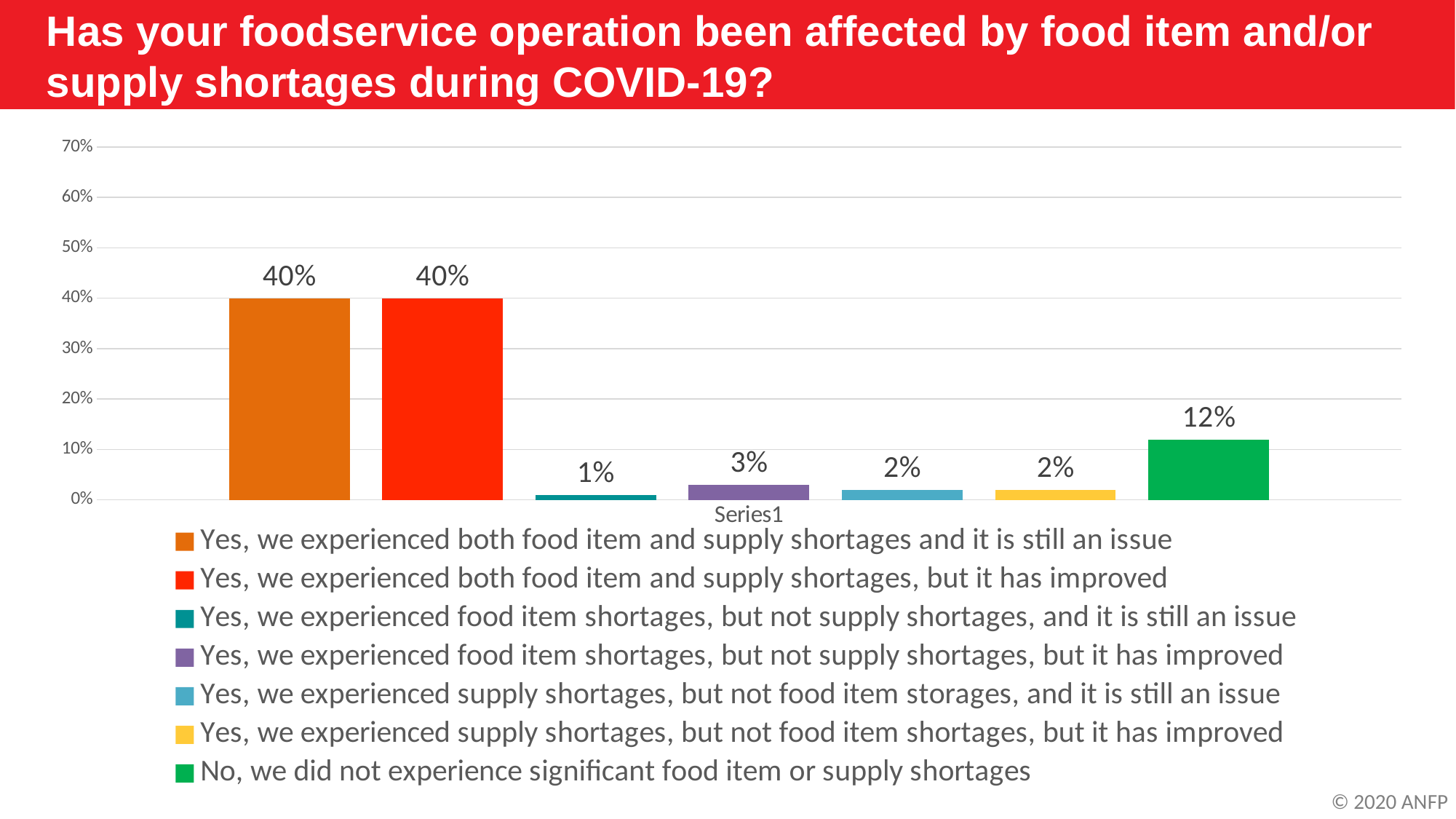
What percentage of respondents said they did not experience significant food item or supply shortages? 12% What colour is the bar for 'No, we did not experience significant food item or supply shortages'? Green Is the value for 'Yes, we experienced both food item and supply shortages, but it has improved' greater or less than 30%? greater What type of chart is shown on the slide? Bar chart Which is larger: the percentage for 'No, we did not experience significant food item or supply shortages' or the percentage for 'Yes, we experienced food item shortages, but not supply shortages, but it has improved'? No, we did not experience significant food item or supply shortages How many entries does the legend list? 7 What percentage of respondents said they experienced supply shortages, but not food item shortages, but it has improved? 2% How many response categories are plotted in the chart? 7 What percentage of respondents said they experienced food item shortages, but not supply shortages, but it has improved? 3% Which response has the lowest percentage? Yes, we experienced food item shortages, but not supply shortages, and it is still an issue What percentage of respondents said they experienced both food item and supply shortages and it is still an issue? 40% What is the difference between the percentage for 'No, we did not experience significant food item or supply shortages' and the percentage for 'Yes, we experienced food item shortages, but not supply shortages, but it has improved'? 9%